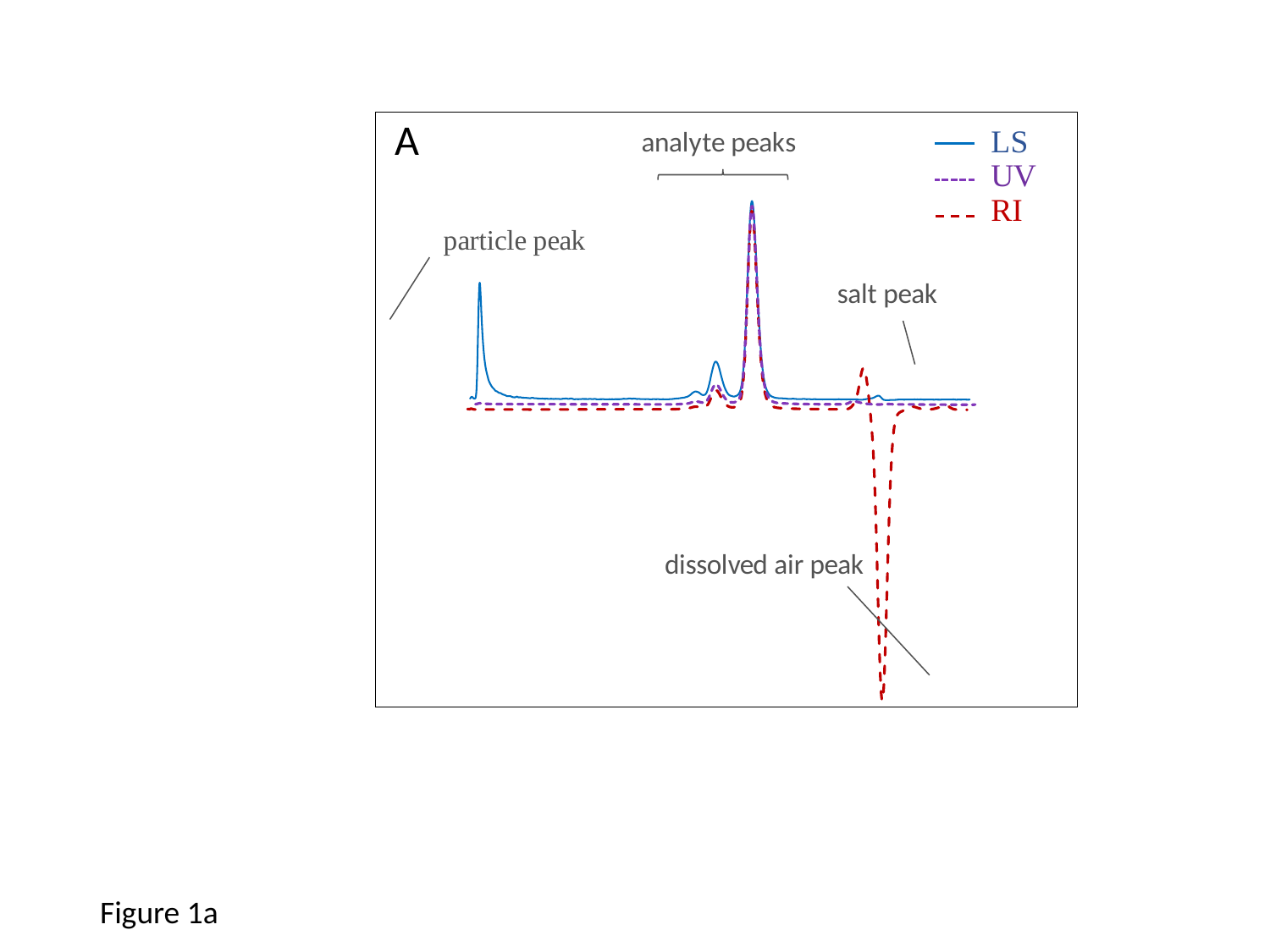
How many series does the legend list? 3 How many labelled peak annotations are on the chart? 4 Which is taller, the particle peak or the main analyte peak? the main analyte peak Which series shows the tall spike labelled 'particle peak' near the left of the chart? LS Which series is drawn as a solid blue line? LS Which series are listed in the legend? LS, UV, RI Which labelled peak reaches the lowest point on the chart? dissolved air peak Which labelled peak is the tallest positive peak on the chart? analyte peaks Which series shows the large negative peak labelled 'dissolved air peak'? RI What kind of chart is shown on the slide? line chart What letter labels the panel in the top-left corner of the chart? A